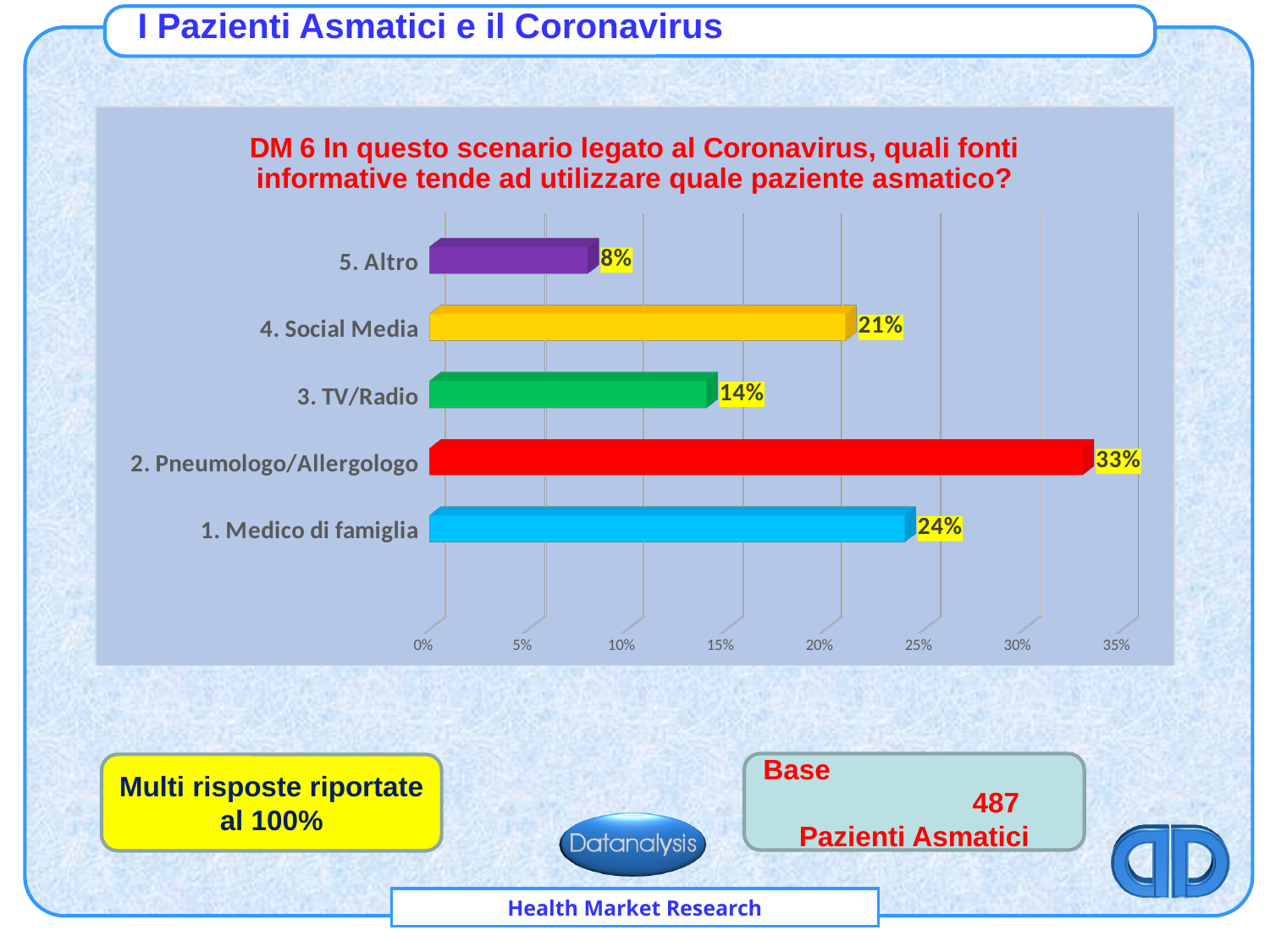
How many categories are shown in the chart? 5 What is the value for 1. Medico di famiglia? 24% What kind of chart is shown on the slide? bar chart What is the value for 5. Altro? 8% Which is larger, the value for 4. Social Media or the value for 3. TV/Radio? 4. Social Media What is the value for 4. Social Media? 21% What is the value for 2. Pneumologo/Allergologo? 33% Which category has the highest value? 2. Pneumologo/Allergologo What is the value for 3. TV/Radio? 14% Is the value for 1. Medico di famiglia greater or less than 20%? greater Which category has the lowest value? 5. Altro What is the difference between the values for 2. Pneumologo/Allergologo and 1. Medico di famiglia? 9%